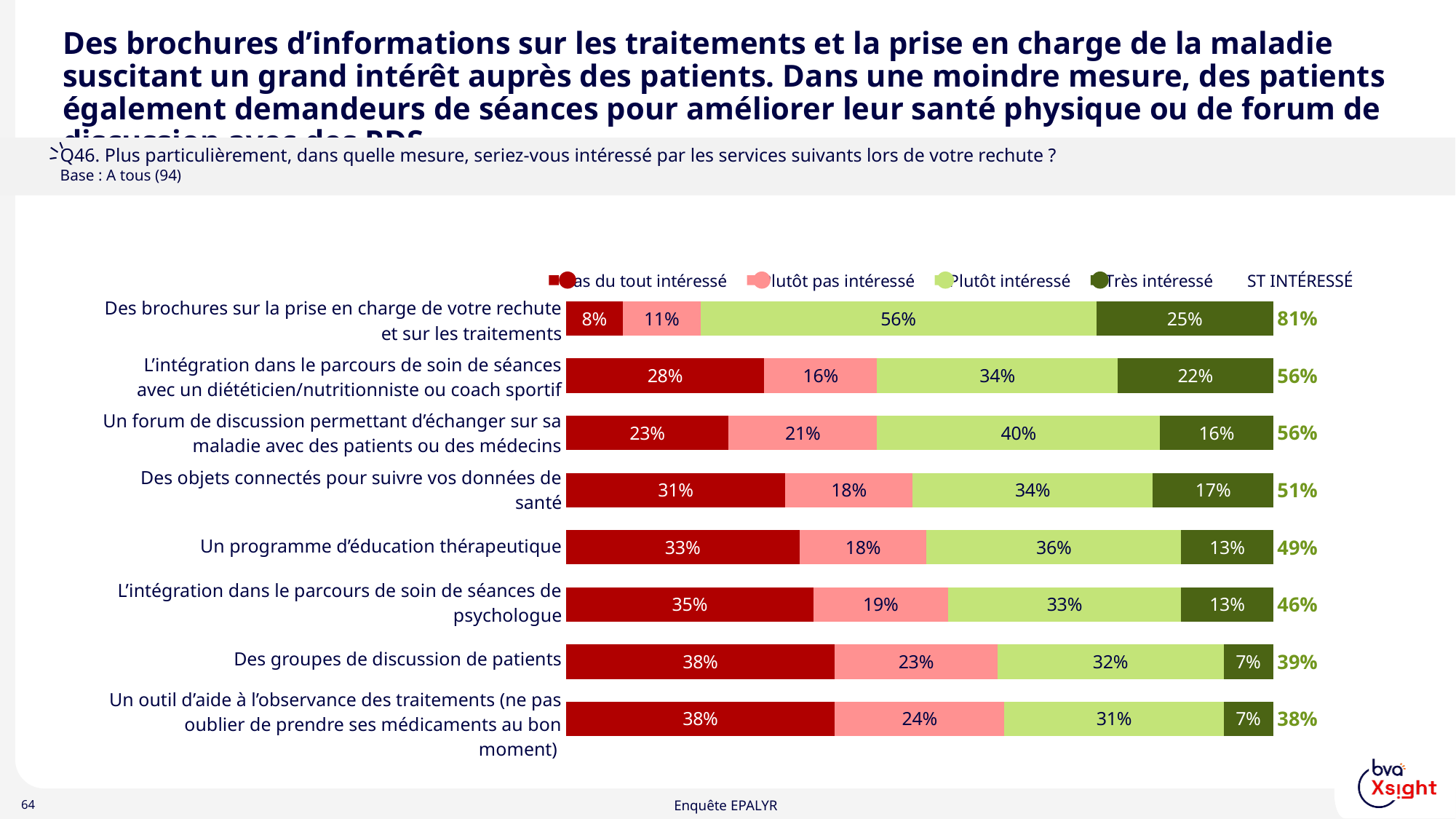
Which category has the highest 'ST INTÉRESSÉ' value? Des brochures sur la prise en charge de votre rechute et sur les traitements What is the 'Plutôt intéressé' value for 'Un forum de discussion permettant d'échanger sur sa maladie avec des patients ou des médecins'? 40% How many service categories are plotted in the chart? 8 What colour represents the 'Très intéressé' series in the chart? Dark green What is the 'Très intéressé' value for 'Des brochures sur la prise en charge de votre rechute et sur les traitements'? 25% What is the 'Pas du tout intéressé' value for 'Un programme d'éducation thérapeutique'? 33% What kind of chart is shown on the slide? Stacked bar chart Which category has the lowest 'ST INTÉRESSÉ' value? Un outil d'aide à l'observance des traitements (ne pas oublier de prendre ses médicaments au bon moment) What is the combined 'Plutôt intéressé' and 'Très intéressé' total for 'L'intégration dans le parcours de soin de séances avec un diététicien/nutritionniste ou coach sportif'? 56% What is the difference between the 'Très intéressé' values for 'Des brochures sur la prise en charge de votre rechute et sur les traitements' and 'Des groupes de discussion de patients'? 18% How many series does the legend list? 4 Which is larger: the 'Pas du tout intéressé' value for 'Des objets connectés pour suivre vos données de santé' or for 'L'intégration dans le parcours de soin de séances de psychologue'? L'intégration dans le parcours de soin de séances de psychologue